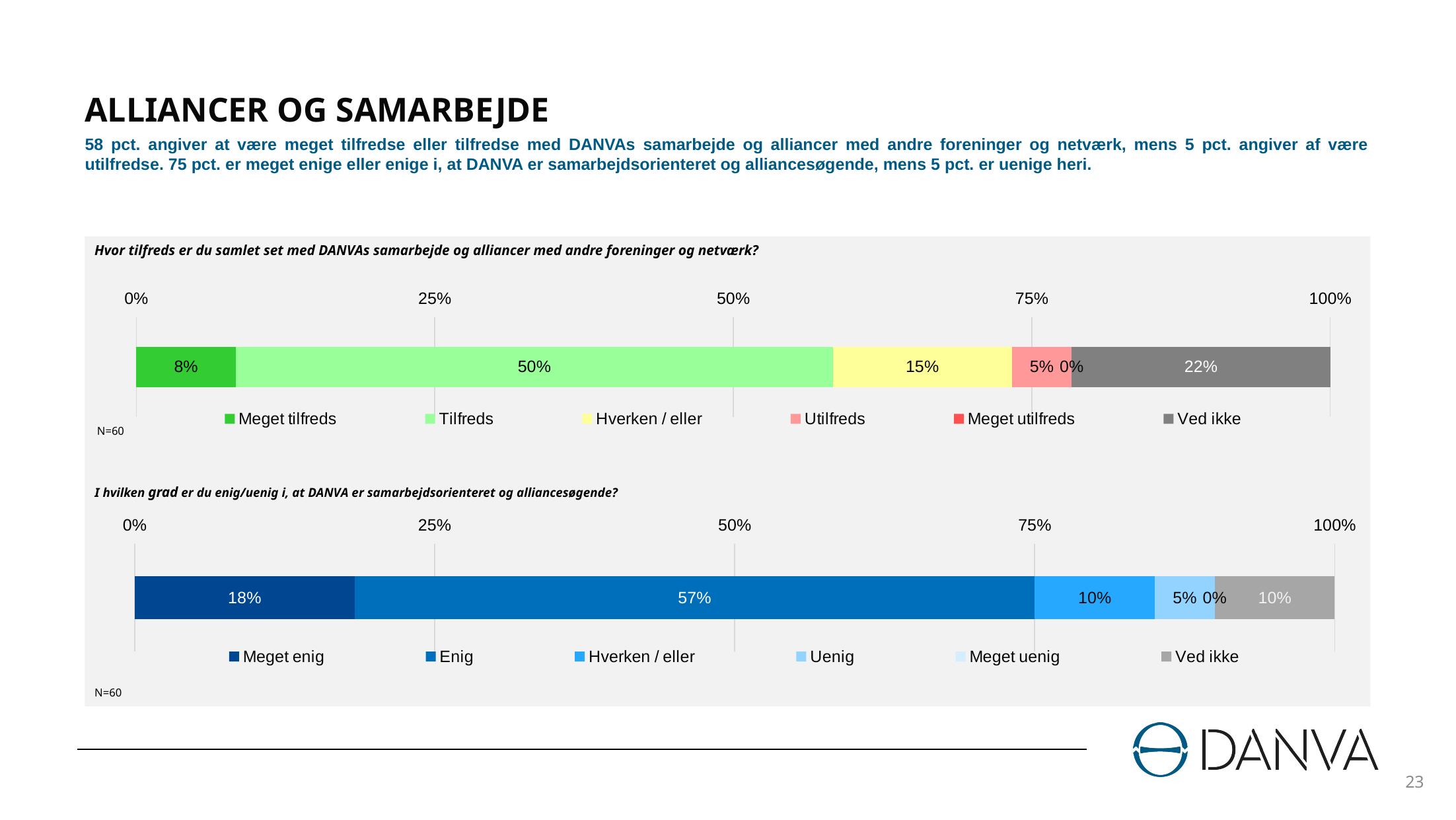
In the top chart, what is the difference between 'Tilfreds' and 'Hverken / eller'? 35% In the top chart, what is the combined share of 'Meget tilfreds' and 'Tilfreds'? 58% In the top chart, what percentage of respondents answered 'Tilfreds'? 50% What type of chart is the top chart? Stacked bar chart In the bottom chart, what is the value for 'Meget enig'? 18% In the bottom chart, which category has the lowest share? Meget uenig In the bottom chart, what percentage answered 'Enig'? 57% How many series does the legend of the bottom chart list? 6 What is the sample size (N) shown for the top chart? N=60 In the top chart, what is the value for 'Ved ikke'? 22% In the top chart, which category has the highest share? Tilfreds In the bottom chart, which is larger, 'Meget enig' or 'Hverken / eller'? Meget enig